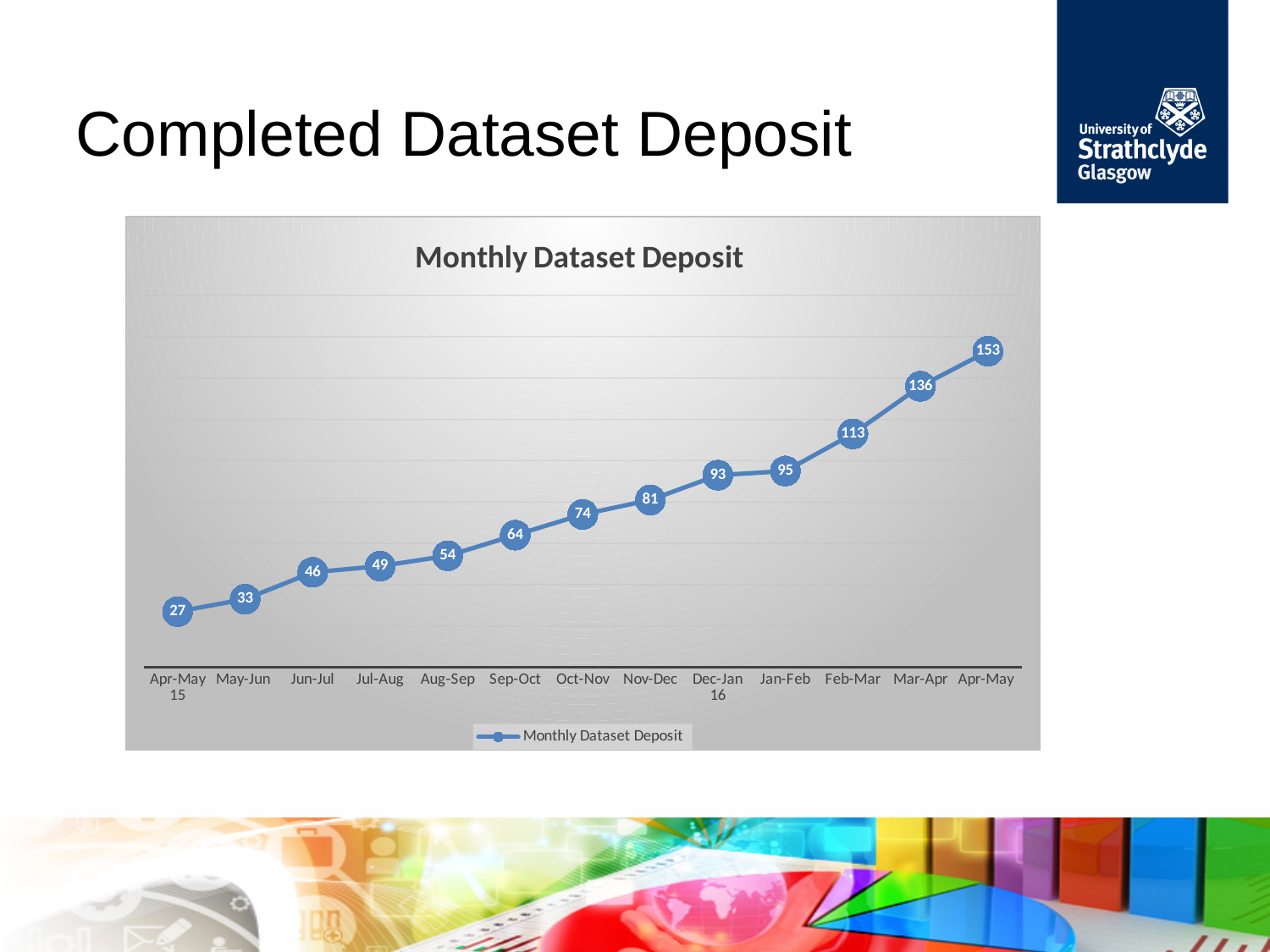
What is the value for Sep-Oct in the Monthly Dataset Deposit chart? 64 What is the difference between the values for Dec-Jan 16 and Nov-Dec in the Monthly Dataset Deposit chart? 12 Which is larger in the Monthly Dataset Deposit chart, the value for Jun-Jul or the value for Oct-Nov? Oct-Nov Which period has the highest value in the Monthly Dataset Deposit chart? Apr-May How many data points are plotted in the Monthly Dataset Deposit chart? 13 Do the values in the Monthly Dataset Deposit chart rise or fall from Apr-May 15 to Apr-May? Rise Which period has the lowest value in the Monthly Dataset Deposit chart? Apr-May 15 What kind of chart is the Monthly Dataset Deposit chart? Line chart What is the difference between the values for Apr-May and Mar-Apr in the Monthly Dataset Deposit chart? 17 What is the value for Feb-Mar in the Monthly Dataset Deposit chart? 113 How many series does the legend of the Monthly Dataset Deposit chart list? 1 What is the value for Apr-May 15 in the Monthly Dataset Deposit chart? 27